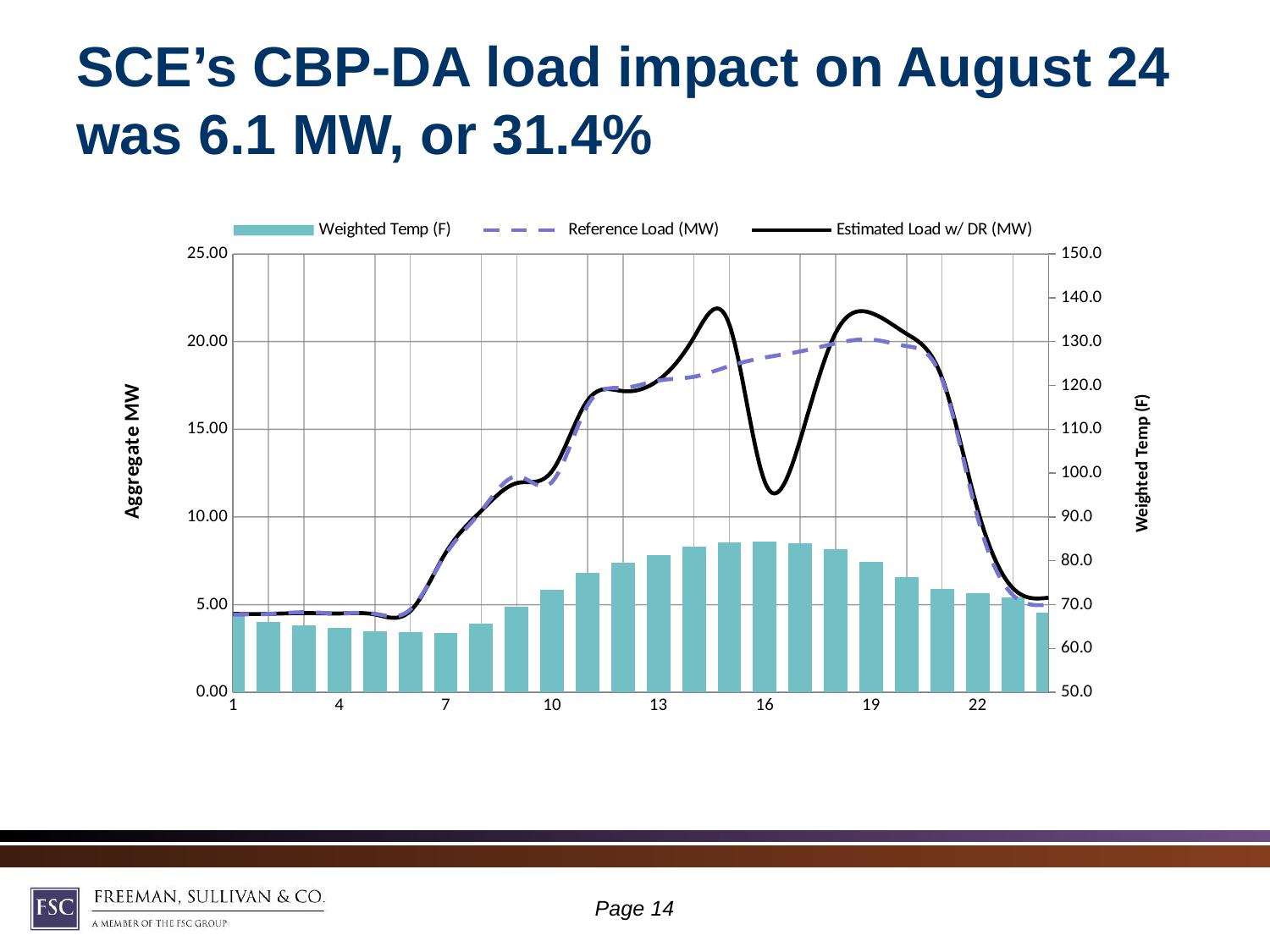
Do the Weighted Temp (F) bars rise or fall from hour 16 to hour 24? fall What is the title of the left vertical axis? Aggregate MW Is the Reference Load (MW) value at hour 16 greater or less than 15? greater Which series is plotted as bars in the chart? Weighted Temp (F) What type of chart is shown on the slide? A combination bar and line chart How many bars (hours) are plotted along the x axis? 24 Is the Weighted Temp (F) at hour 15 greater or less than 80.0? greater At hour 16, which is higher: Reference Load (MW) or Estimated Load w/ DR (MW)? Reference Load (MW) Is the peak of the Estimated Load w/ DR (MW) line around hour 15 greater or less than 20? greater How many series does the chart legend list? 3 Does the Estimated Load w/ DR (MW) line rise or fall from hour 1 to hour 14? rise